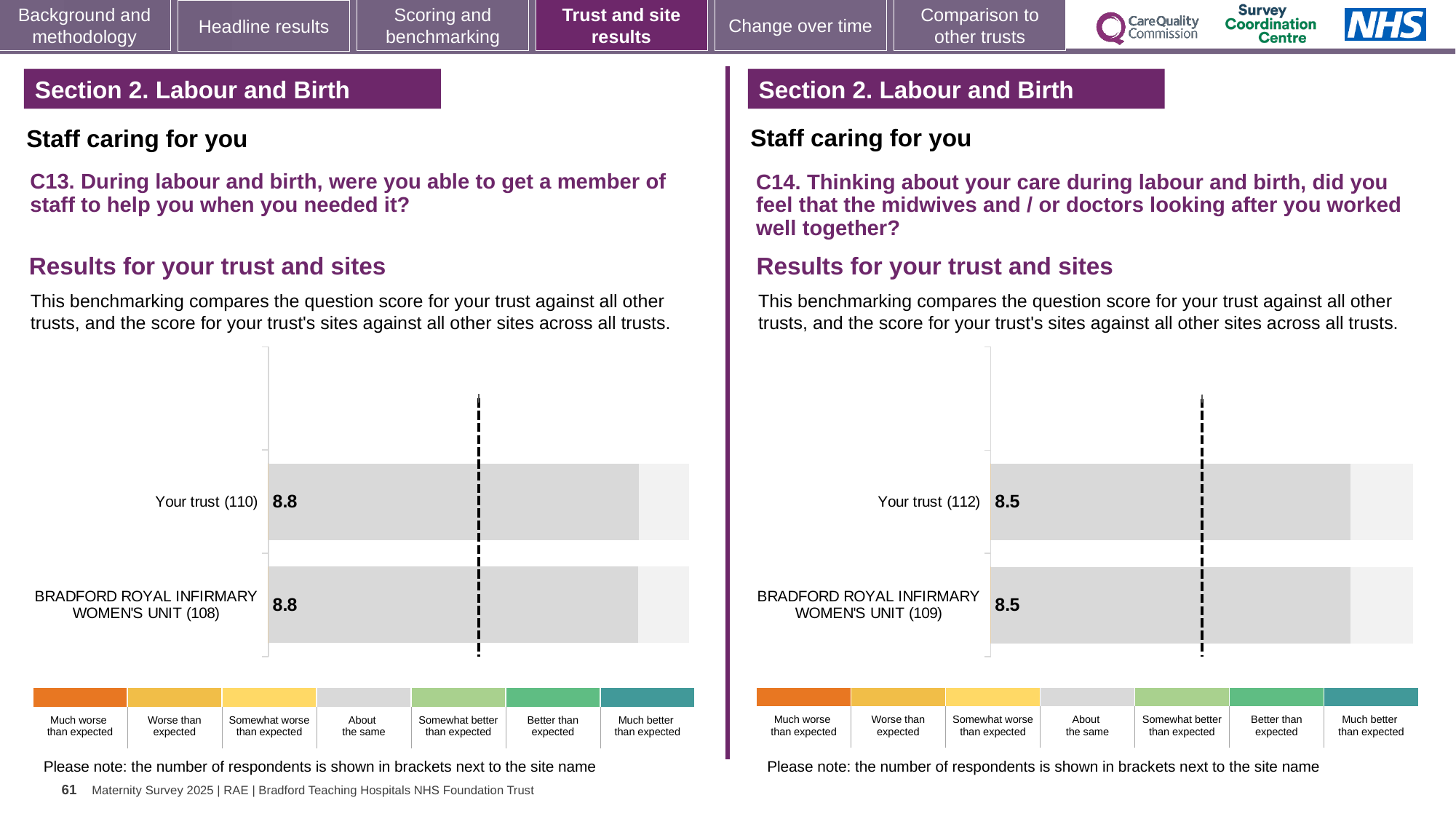
On the left chart (C13), what is the difference between the score for Your trust and the score for BRADFORD ROYAL INFIRMARY WOMEN'S UNIT? 0 How many bars are plotted on the right chart (C14)? 2 How many bars are plotted on the left chart (C13)? 2 On the left chart (C13), how many respondents are shown in brackets for Your trust? 110 On the right chart (C14), what is the score for Your trust? 8.5 On the right chart (C14), what is the difference between the score for Your trust and the score for BRADFORD ROYAL INFIRMARY WOMEN'S UNIT? 0 Is the score for Your trust on the left chart (C13) larger or smaller than the score for Your trust on the right chart (C14)? Larger On the left chart (C13), what is the score for BRADFORD ROYAL INFIRMARY WOMEN'S UNIT? 8.8 On the left chart (C13), what is the score for Your trust? 8.8 On the right chart (C14), how many respondents are shown in brackets for BRADFORD ROYAL INFIRMARY WOMEN'S UNIT? 109 What type of chart is used on the left (C13)? Bar chart On the right chart (C14), what is the score for BRADFORD ROYAL INFIRMARY WOMEN'S UNIT? 8.5